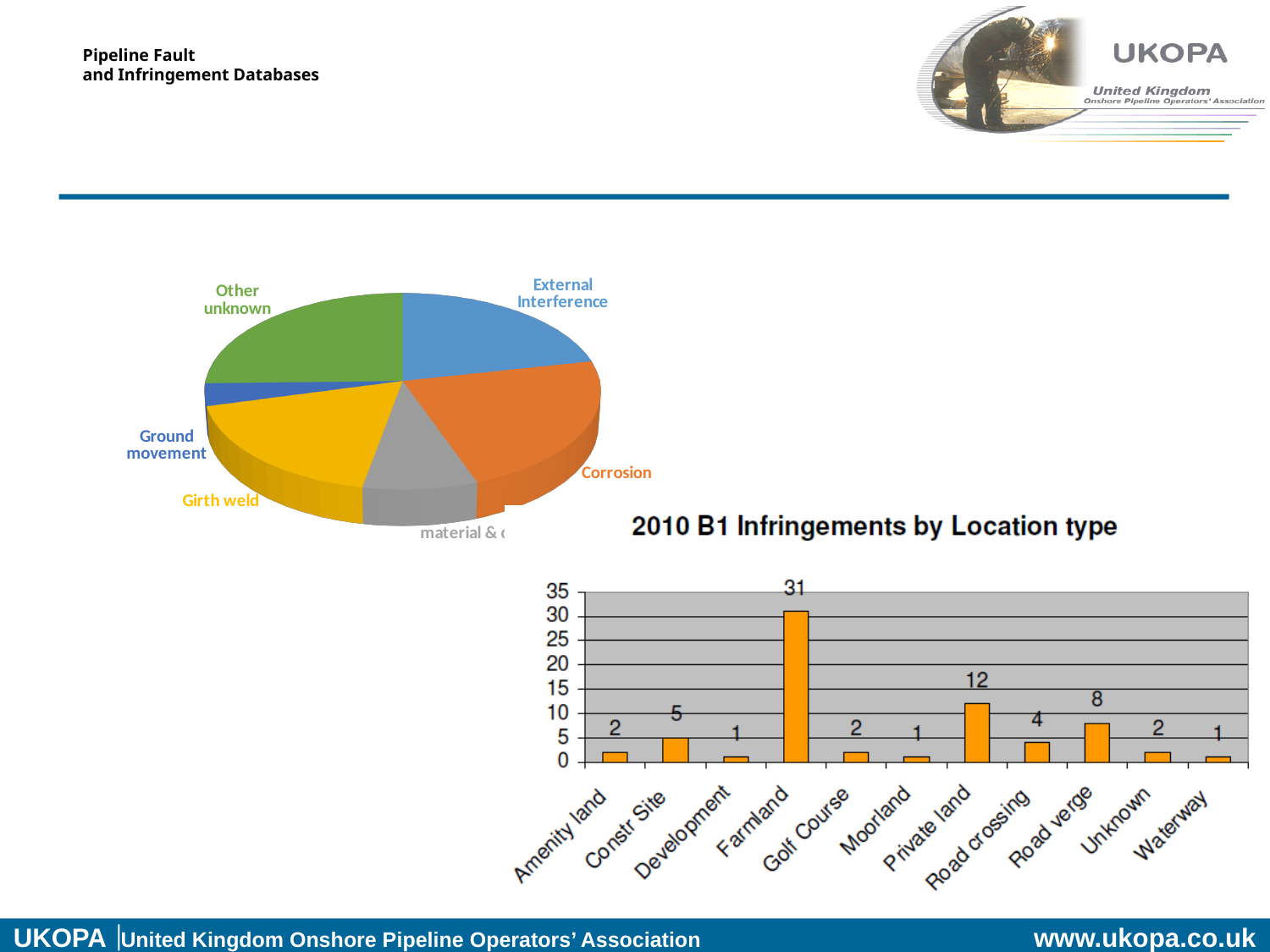
What kind of chart is the chart on the left side of the slide? pie chart In the chart titled '2010 B1 Infringements by Location type', what is the value for Private land? 12 In the chart titled '2010 B1 Infringements by Location type', is the value for Private land greater or less than 10? greater In the chart titled '2010 B1 Infringements by Location type', which location type has the highest value? Farmland What kind of chart is the '2010 B1 Infringements by Location type' chart? bar chart In the chart titled '2010 B1 Infringements by Location type', what is the value for Road verge? 8 In the chart titled '2010 B1 Infringements by Location type', how many location types are shown on the x axis? 11 In the pie chart on the left side of the slide, which category has the smallest slice? Ground movement In the chart titled '2010 B1 Infringements by Location type', which is larger, the value for Constr Site or the value for Road crossing? Constr Site In the chart titled '2010 B1 Infringements by Location type', what is the difference between the values for Farmland and Private land? 19 How many slices does the pie chart on the left side of the slide have? 6 In the chart titled '2010 B1 Infringements by Location type', what is the value for Farmland? 31